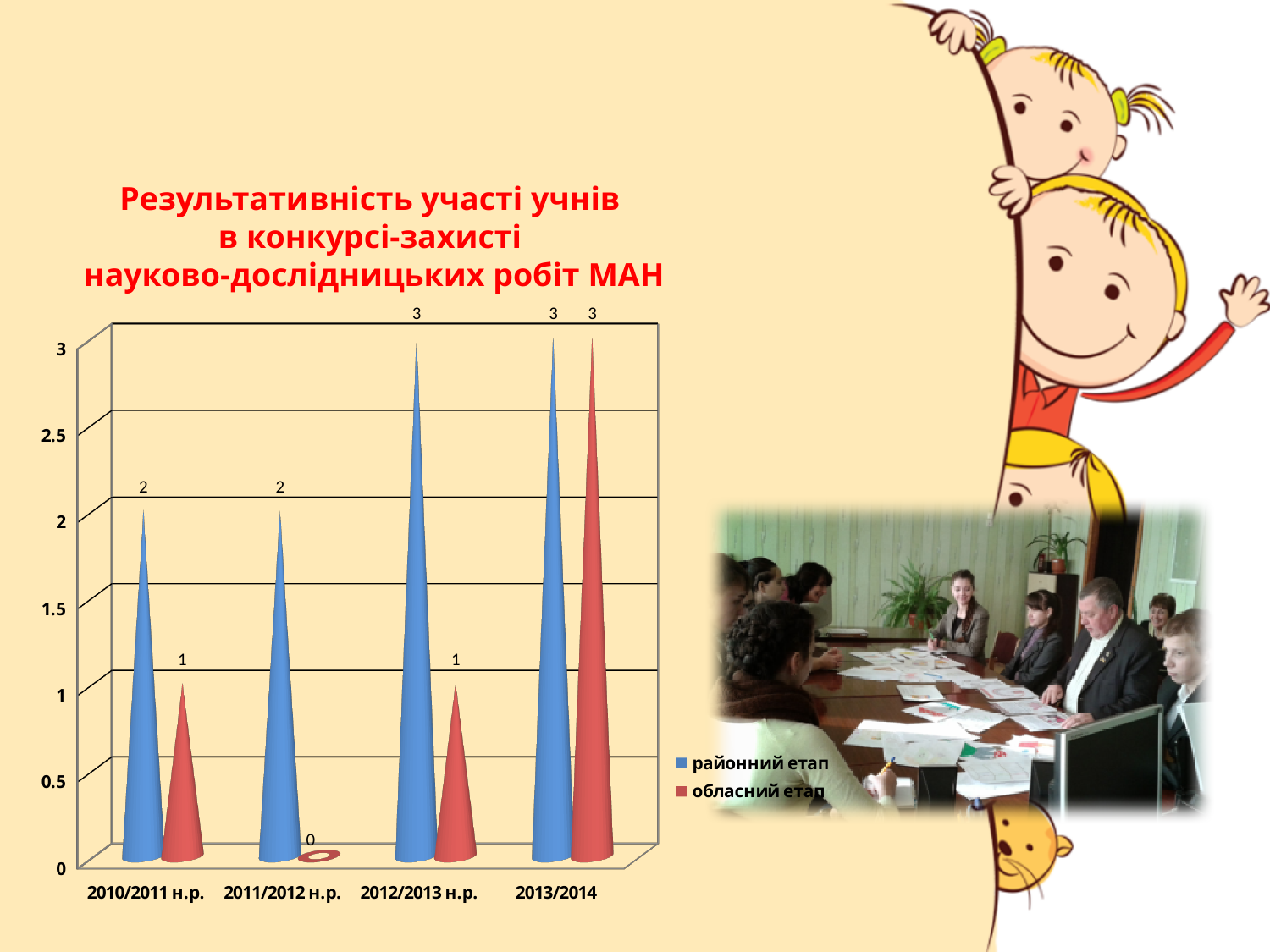
What is the value for районний етап in 2010/2011 н.р.? 2 Which series is shown in blue according to the legend? районний етап What is the value for обласний етап in 2013/2014? 3 In which year is the value for обласний етап the lowest? 2011/2012 н.р. What is the difference between районний етап and обласний етап in 2012/2013 н.р.? 2 What is the value for районний етап in 2012/2013 н.р.? 3 How many years (categories) are shown on the x axis? 4 What kind of chart is shown on the slide? bar chart In which year is the value for обласний етап the highest? 2013/2014 What is the value for обласний етап in 2011/2012 н.р.? 0 How many series does the legend list? 2 Which is larger in 2010/2011 н.р.: районний етап or обласний етап? районний етап